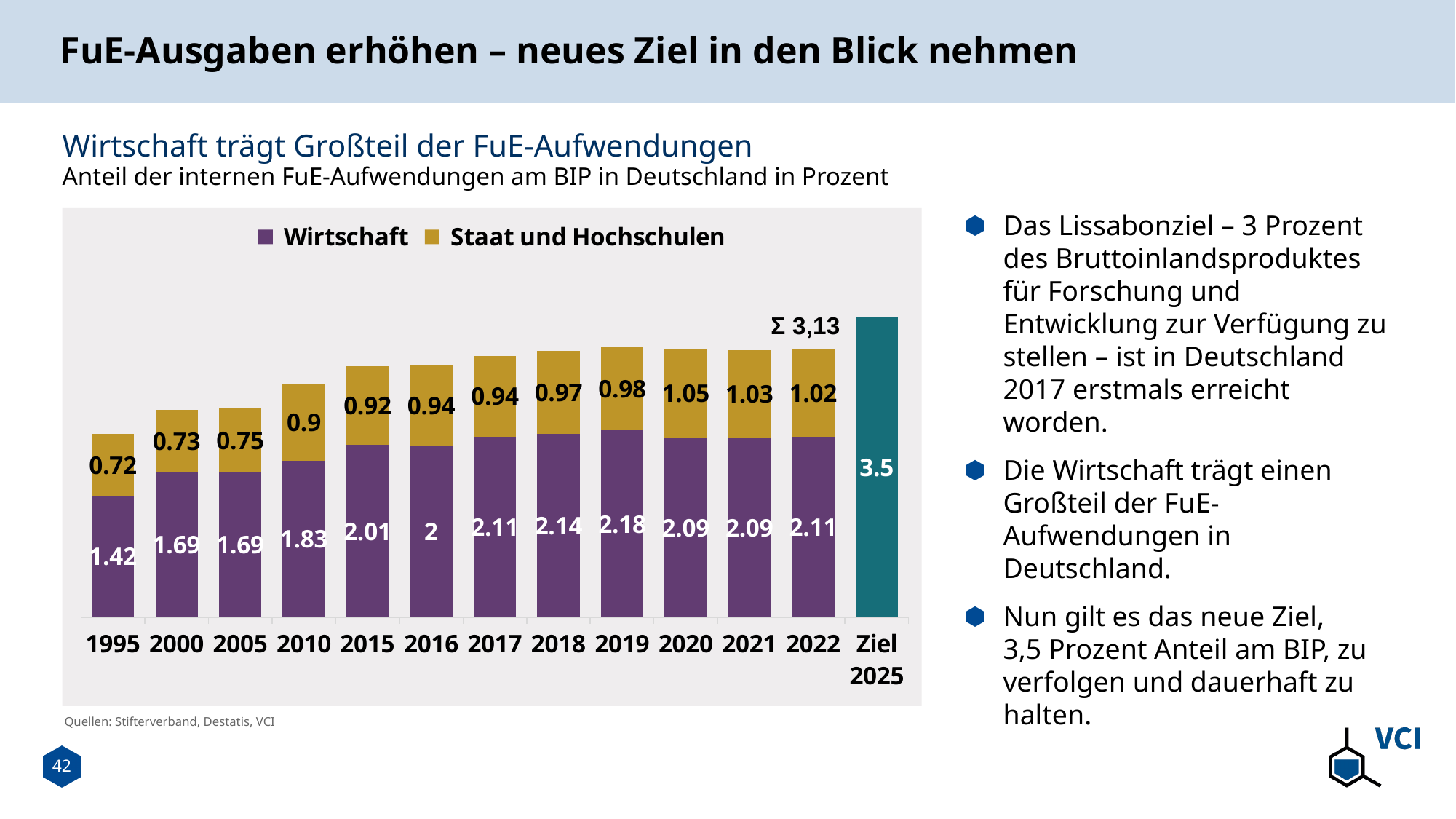
Which is larger, the Wirtschaft value in 2018 or in 2020? 2018 What is the value for Staat und Hochschulen in 2020? 1.05 What is the total of the stacked bar for 2022? 3,13 How many categories are shown on the x axis? 13 In which year is the Wirtschaft value highest? 2019 What kind of chart is shown on the slide? Stacked bar chart What value is shown for the Ziel 2025 bar? 3.5 How many series does the legend list? 2 What is the total of the stacked bar for 2019? 3.16 What is the difference between the Wirtschaft value in 2022 and in 1995? 0.69 What is the value for Wirtschaft in 2019? 2.18 In which year is the Staat und Hochschulen value lowest? 1995